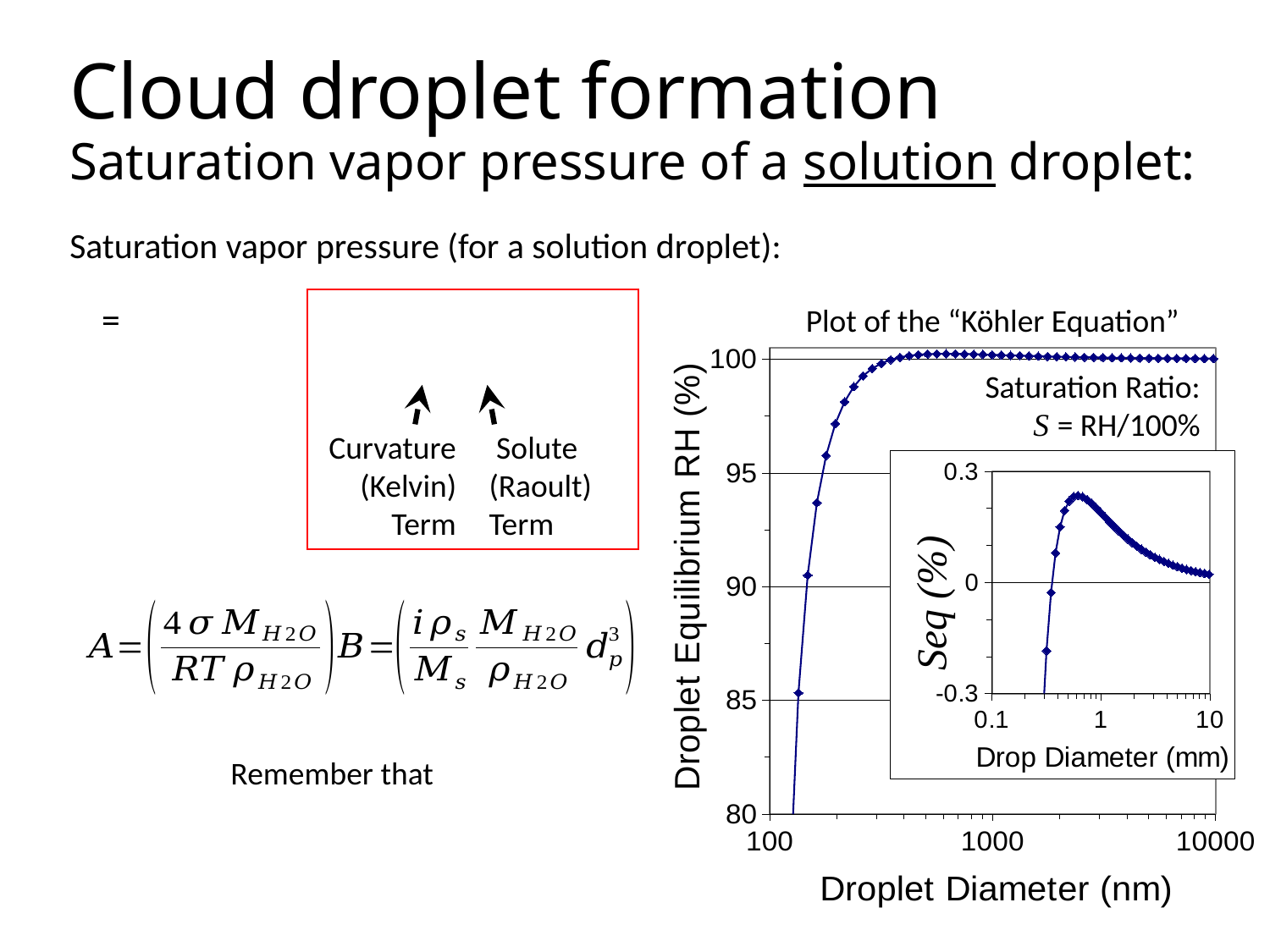
In the inset chart (Seq vs Drop Diameter), is the peak value of Seq greater or less than 0? greater In the inset chart (Seq vs Drop Diameter), is the peak value of Seq greater or less than 0.3? less What kind of chart is the inset chart of Seq versus Drop Diameter? line chart What kind of chart is the main 'Plot of the "Köhler Equation"'? line chart In the inset chart (Seq vs Drop Diameter), does Seq rise or fall as Drop Diameter increases from 1 mm to 10 mm? fall In the main Köhler Equation chart, is the Droplet Equilibrium RH at a droplet diameter of 10000 nm greater or less than 90? greater In the main Köhler Equation chart, what is the lowest value shown on the y axis? 80 In the inset chart, what is the label of the x axis? Drop Diameter (mm) In the main Köhler Equation chart, does the Droplet Equilibrium RH rise or fall as Droplet Diameter increases from 100 nm to 1000 nm? rise In the main Köhler Equation chart, what is the label of the y axis? Droplet Equilibrium RH (%)